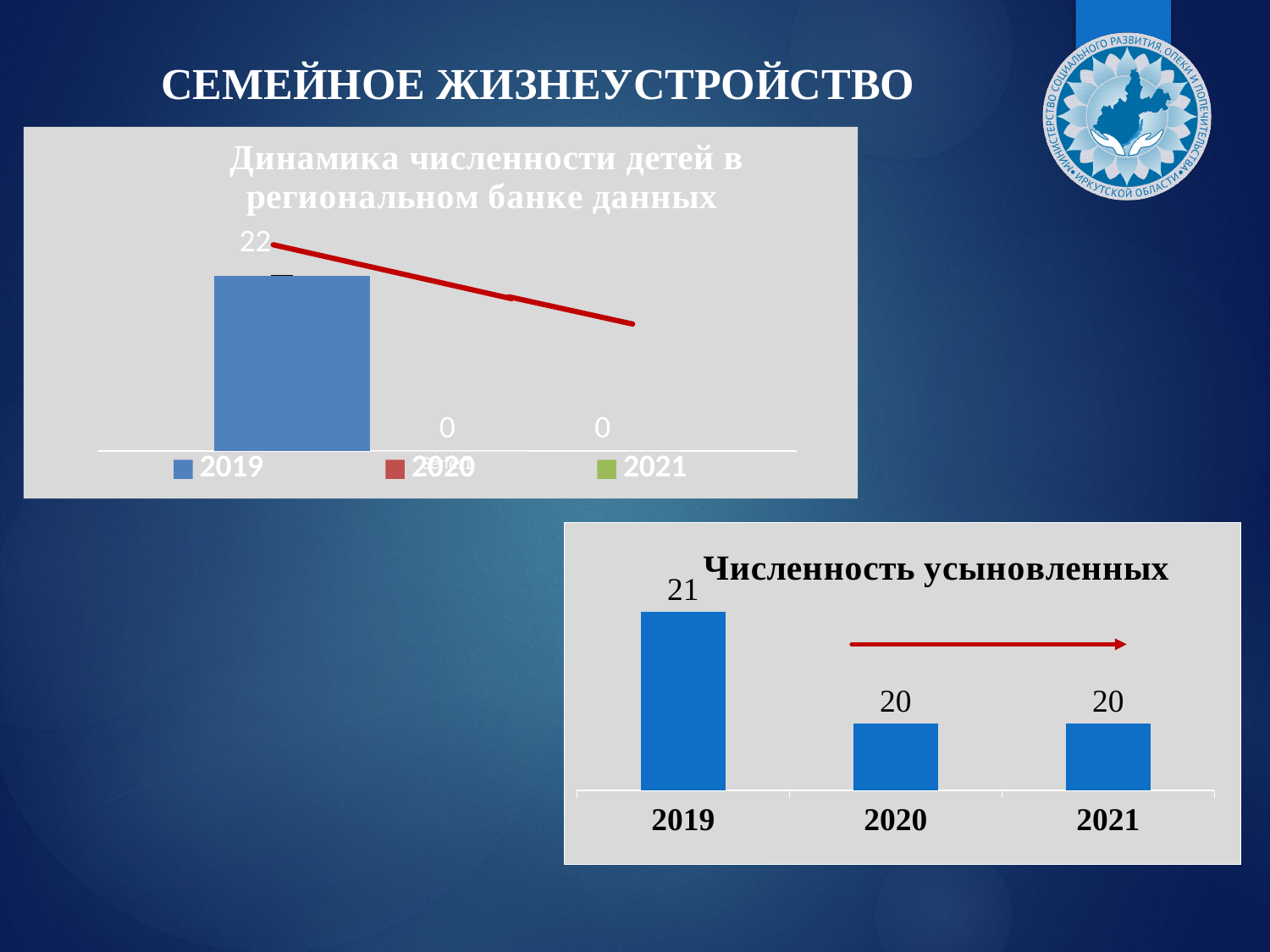
In the chart titled "Численность усыновленных", what is the value for 2019? 21 In the chart titled "Численность усыновленных", do the values rise or fall from 2019 to 2020? fall In the chart titled "Численность усыновленных", what is the difference between the values for 2019 and 2020? 1 In the chart titled "Численность усыновленных", which year has the highest value? 2019 In the chart titled "Динамика численности детей в региональном банке данных", how many entries does the legend list? 3 What kind of chart is the chart titled "Численность усыновленных"? bar chart In the chart titled "Численность усыновленных", how many years are shown on the x axis? 3 In the chart titled "Динамика численности детей в региональном банке данных", what is the value for 2019? 22 In the chart titled "Численность усыновленных", what is the value for 2021? 20 Which chart on the slide has the larger value for 2019, the top chart or the bottom chart? the top chart In the chart titled "Динамика численности детей в региональном банке данных", which year has the highest value? 2019 In the chart titled "Численность усыновленных", what is the value for 2020? 20